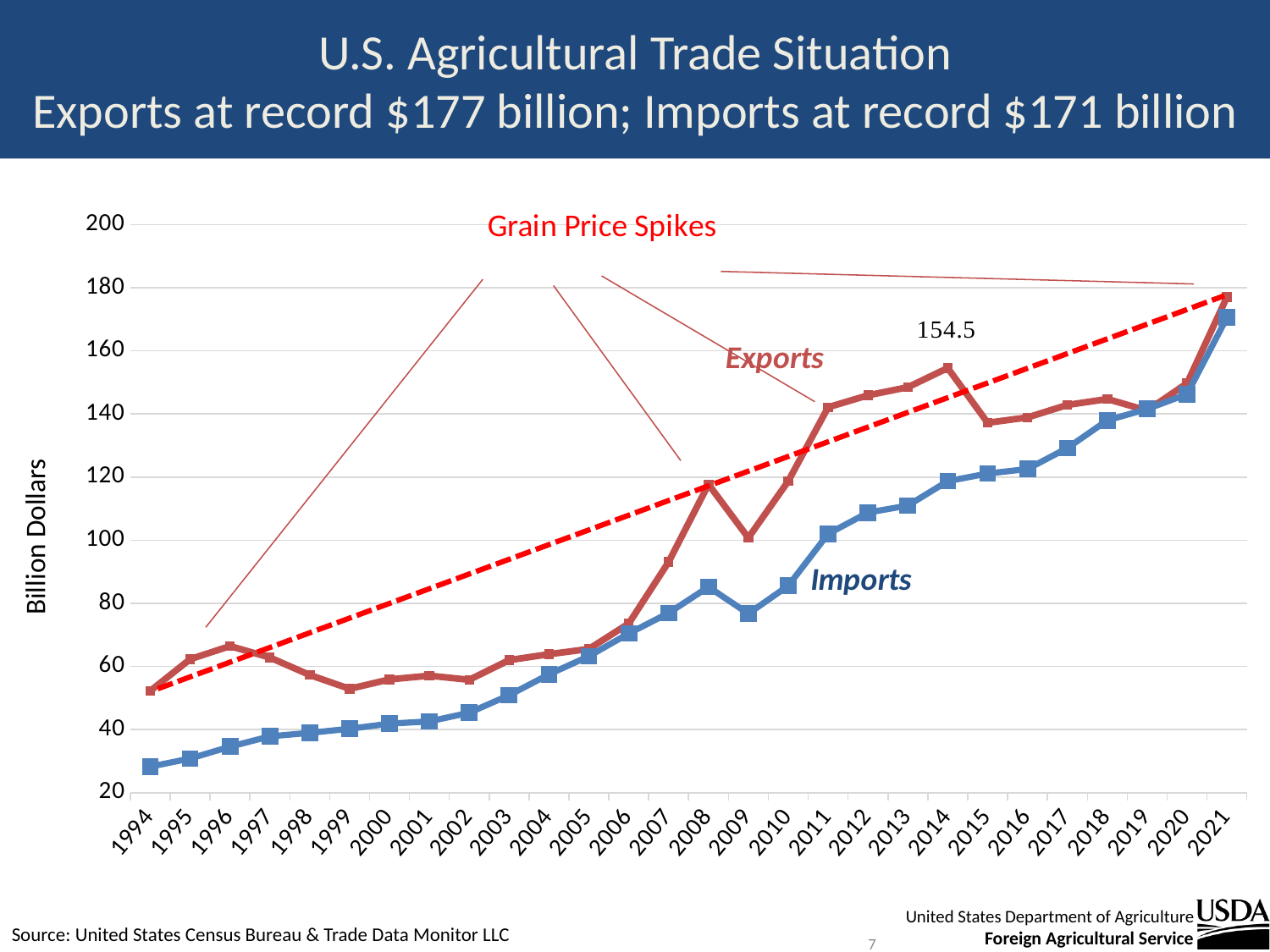
What record value did Exports reach in 2021, according to the slide? $177 billion How many data series are plotted on the chart? 2 What type of chart is shown on the slide? line chart In 2008, which is larger, Exports or Imports? Exports What record value did Imports reach in 2021, according to the slide? $171 billion What is the label on the y axis? Billion Dollars Is the value for Imports in 2000 greater or less than 60? less In which year are Imports at their lowest? 1994 What is the value of Exports in 2014? 154.5 By how much did the record Exports value exceed the record Imports value in 2021? $6 billion How many years are shown on the x axis? 28 In which year are Exports at their highest? 2021